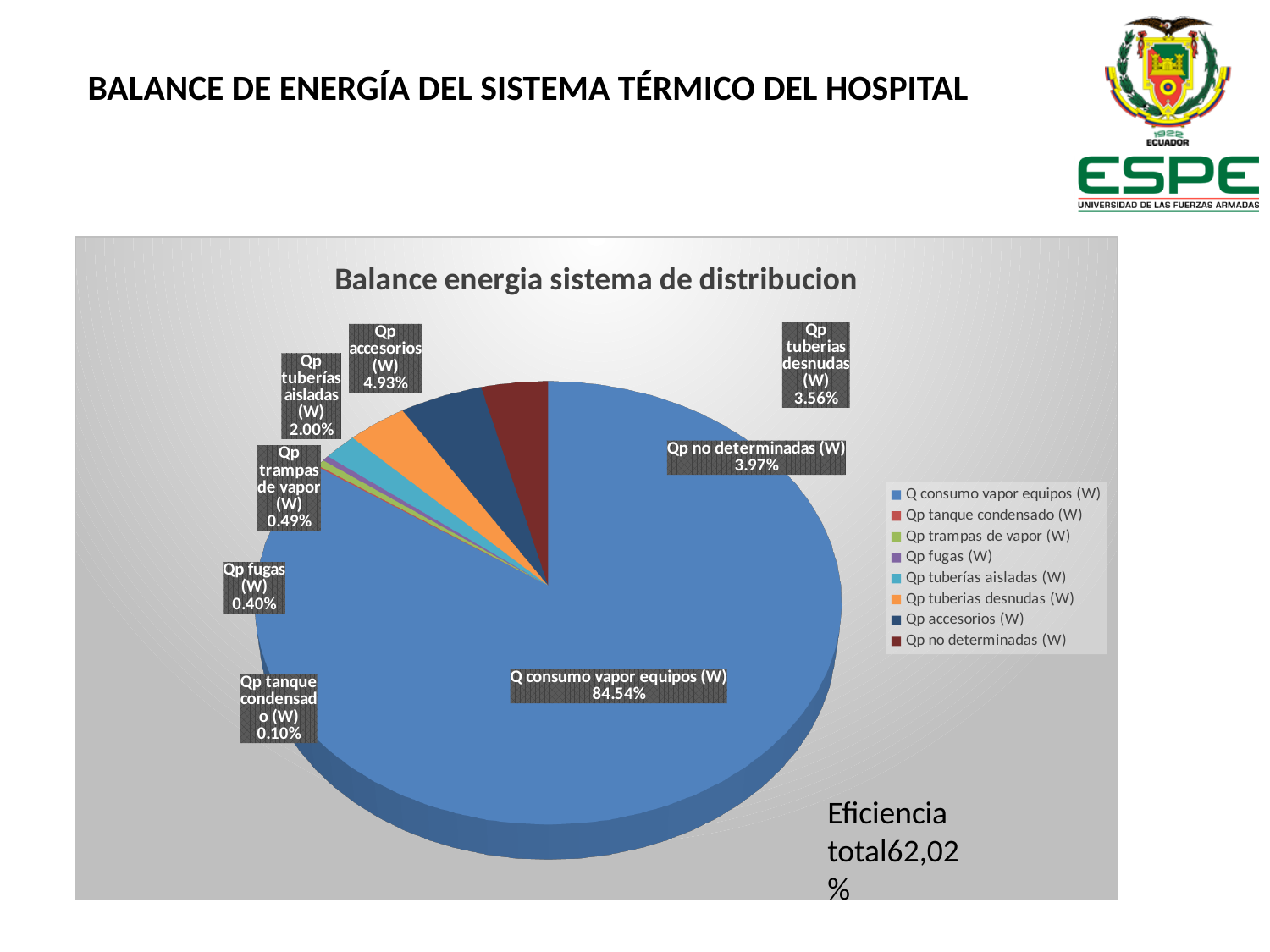
What percentage is shown for Qp accesorios (W)? 4.93% What is the difference in percentage points between Qp accesorios (W) and Qp no determinadas (W)? 0.96% How many entries does the legend list? 8 Which is larger, the share for Qp accesorios (W) or the share for Qp tuberias desnudas (W)? Qp accesorios (W) What is the title of the chart? Balance energia sistema de distribucion What percentage is shown for Q consumo vapor equipos (W)? 84.54% What percentage is shown for Qp no determinadas (W)? 3.97% Which category has the smallest share of the pie? Qp tanque condensado (W) What percentage is shown for Qp tanque condensado (W)? 0.10% What percentage is shown for Qp tuberias desnudas (W)? 3.56% Which category has the largest share of the pie? Q consumo vapor equipos (W) What kind of chart is shown on the slide? Pie chart